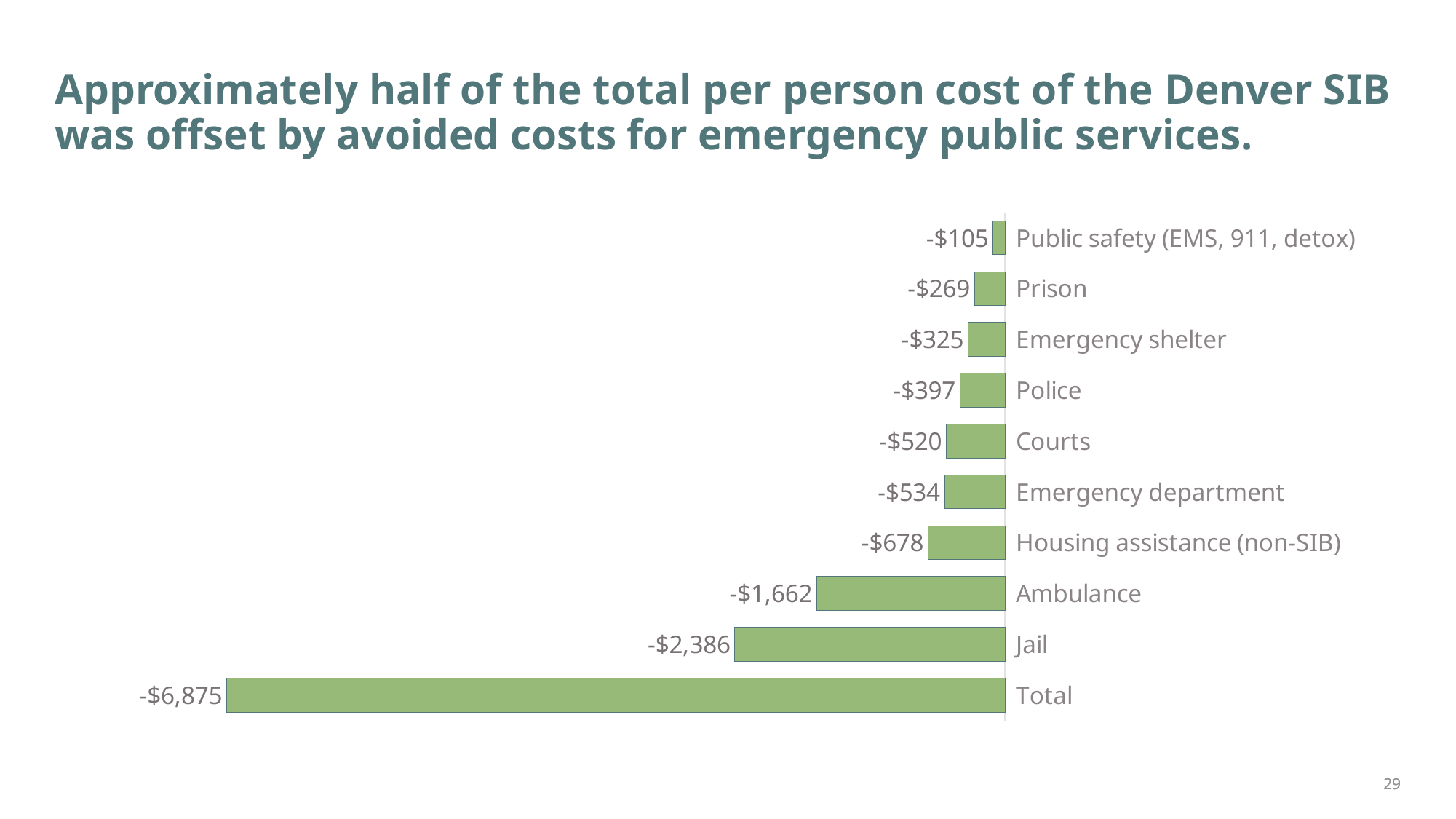
What is the value for Emergency shelter? -$325 Which category has the smallest avoided cost (closest to zero)? Public safety (EMS, 911, detox) How many bars are shown in the chart, including Total? 10 What is the value for Housing assistance (non-SIB)? -$678 What kind of chart is shown on the slide? Bar chart What is the difference between the values for Jail and Ambulance? $724 What is the difference between the values for Police and Prison? $128 What is the value shown for Total? -$6,875 Which has a larger avoided cost, Courts or Police? Courts What is the value for Ambulance? -$1,662 Excluding Total, which category has the largest avoided cost? Jail What is the value for Jail? -$2,386